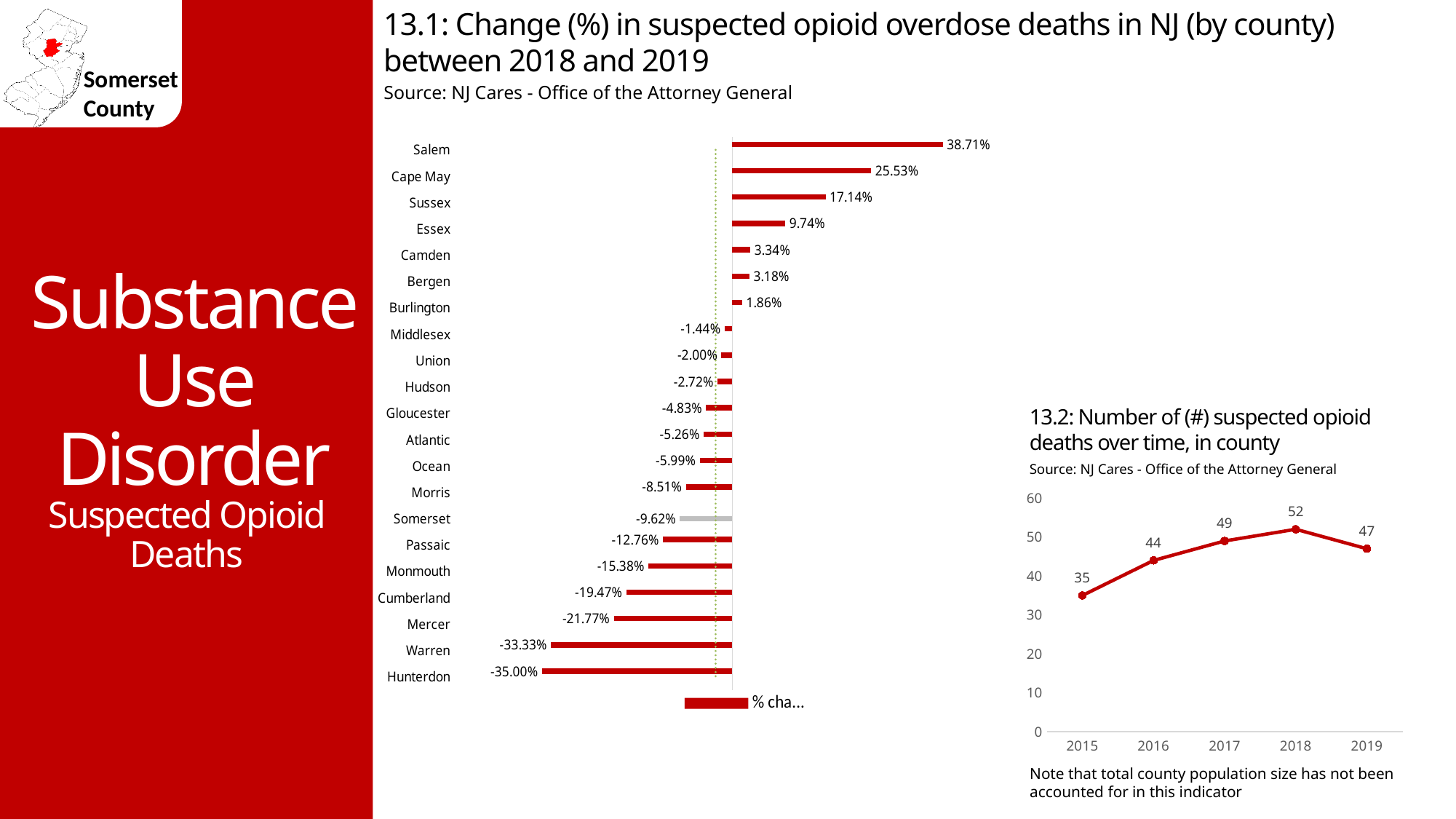
In chart 13.2, which year had the lowest number of suspected opioid deaths? 2015 In chart 13.1, which county has the highest percentage change? Salem In chart 13.1, what is the difference between the percentage change for Salem and Cape May? 13.18% What type of chart is chart 13.1? Bar chart In chart 13.1, what is the percentage change for Cape May? 25.53% In chart 13.1, which has a larger percentage change, Essex or Camden? Essex In chart 13.1, how many counties are shown? 21 In chart 13.2, how many suspected opioid deaths were there in 2018? 52 In chart 13.2, what is the difference in suspected opioid deaths between 2019 and 2015? 12 In chart 13.1, what is the percentage change in suspected opioid overdose deaths for Somerset? -9.62% In chart 13.1, which county has the lowest percentage change? Hunterdon What type of chart is chart 13.2? Line chart